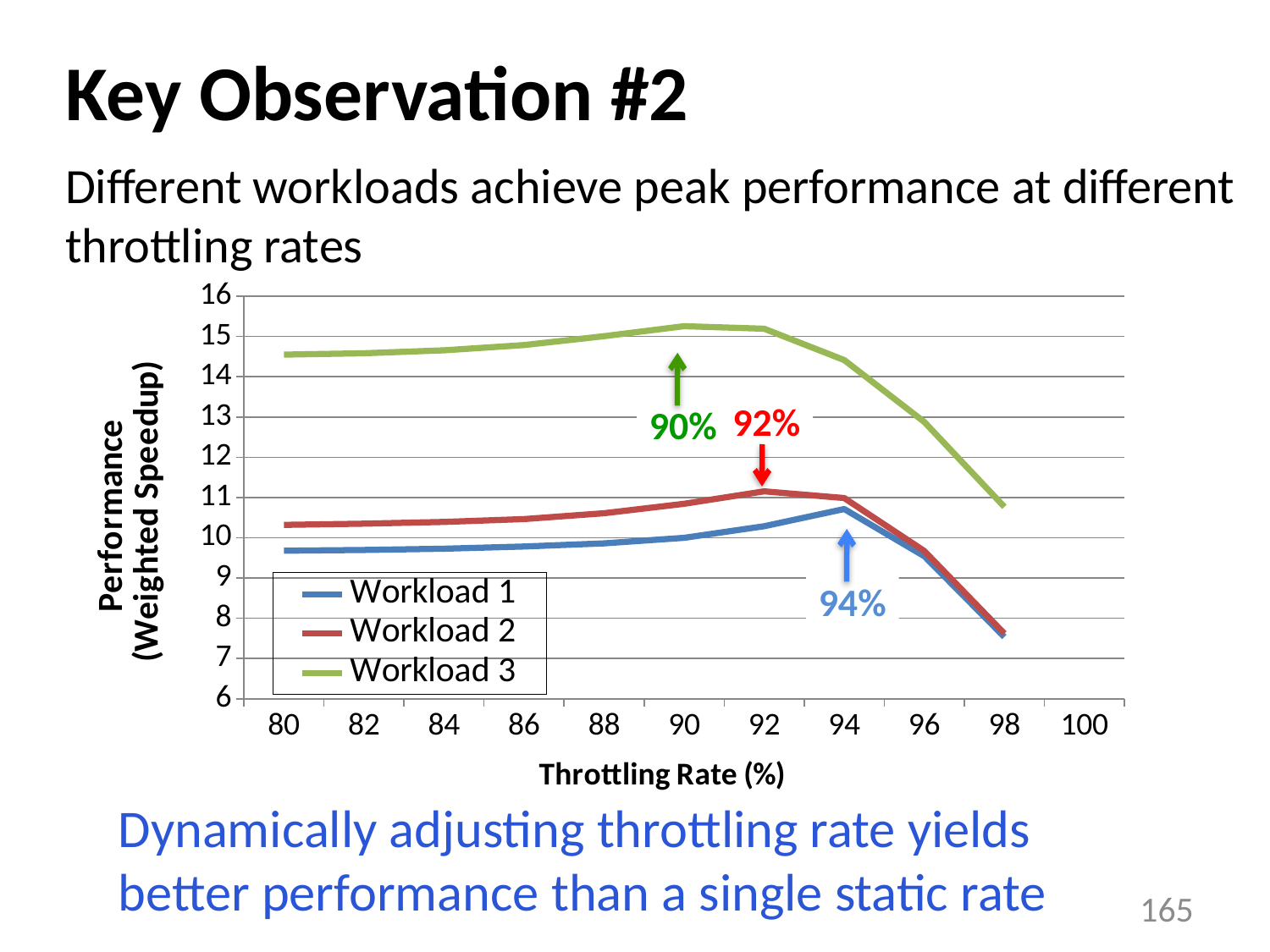
At a throttling rate of 92, which is larger: Workload 2 or Workload 1? Workload 2 What is the title of the y axis? Performance (Weighted Speedup) What kind of chart is shown on the slide? line chart Which workload has the highest performance at a throttling rate of 80? Workload 3 Does the performance of Workload 3 rise or fall as the throttling rate goes from 94 to 98? fall Is the value for Workload 3 at a throttling rate of 90 greater or less than 15? greater Is the value for Workload 1 at a throttling rate of 80 greater or less than 10? less Is the value for Workload 1 at a throttling rate of 98 greater or less than 8? less According to the annotation on the chart, at what throttling rate does Workload 2 reach its peak performance? 92% How many series does the legend list? 3 What is the title of the x axis? Throttling Rate (%)